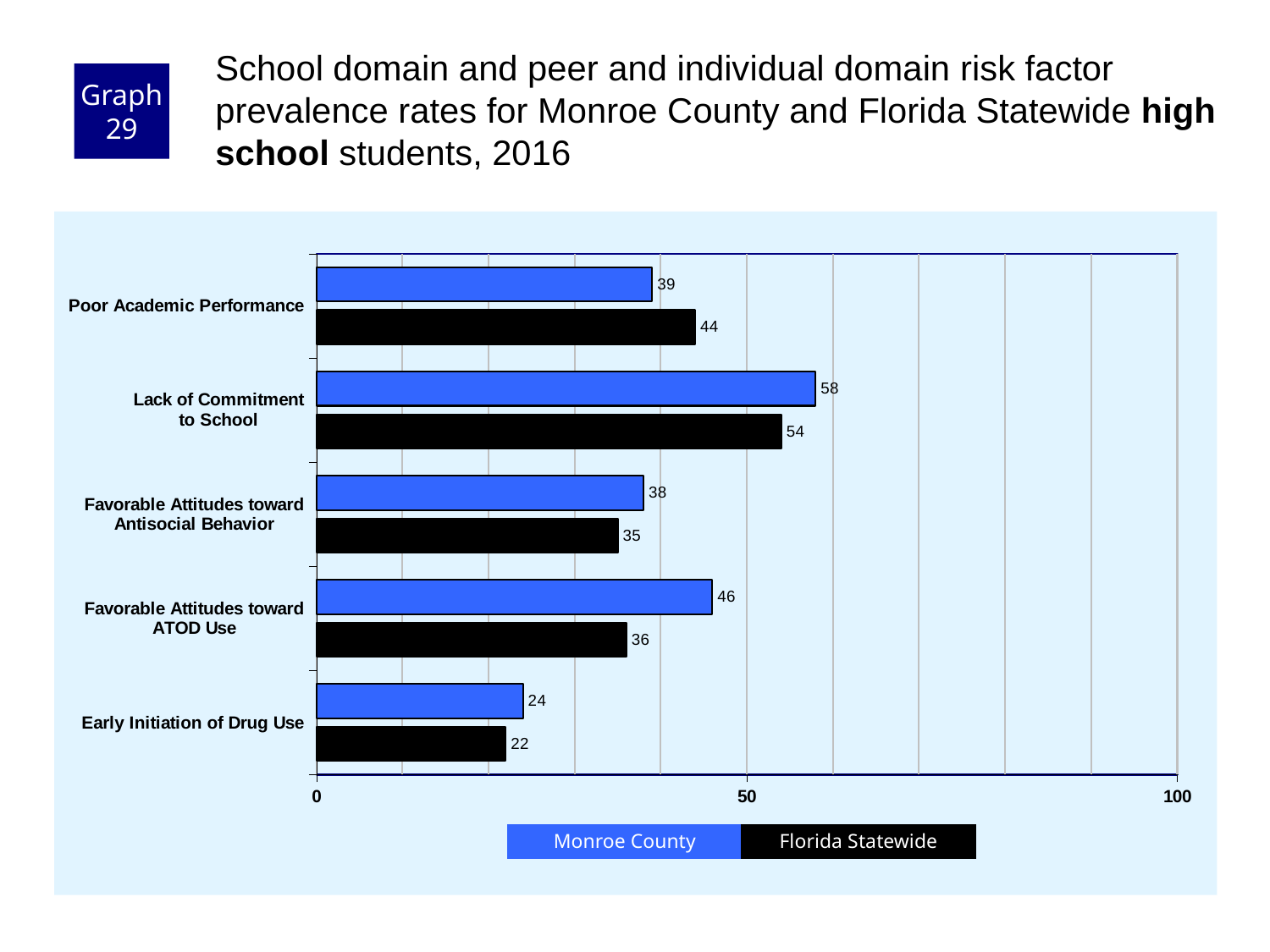
Which risk factor has the lowest Florida Statewide value? Early Initiation of Drug Use What is the difference between the Monroe County and Florida Statewide values for Favorable Attitudes toward ATOD Use? 10 What kind of chart is shown on the slide? bar chart Which colour represents Florida Statewide in the chart? black For Poor Academic Performance, which is larger: Monroe County or Florida Statewide? Florida Statewide How many risk factor categories are shown on the chart? 5 How many series does the legend list? 2 Is the Monroe County value for Lack of Commitment to School greater or less than 50? greater What is the Monroe County value for Early Initiation of Drug Use? 24 What is the Monroe County value for Lack of Commitment to School? 58 Which risk factor has the highest Monroe County value? Lack of Commitment to School What is the Florida Statewide value for Poor Academic Performance? 44